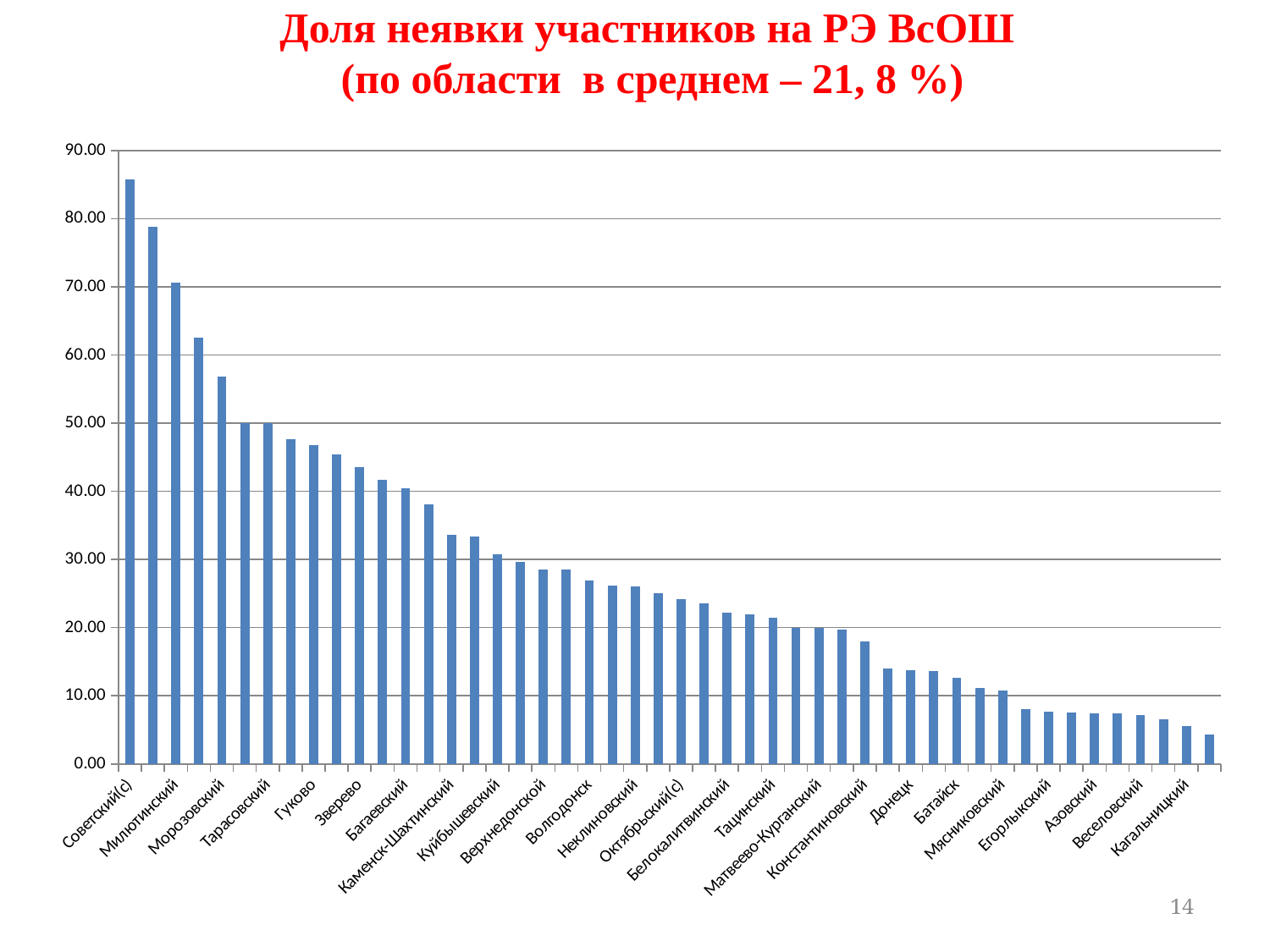
Is the value for Гуково greater or less than 50? less Is the value for Кагальницкий greater or less than 10? less Is the value for Милютинский greater or less than 60? greater Which category has the highest value? Советский(с) What kind of chart is shown on the slide? bar chart What average value for the region is stated in the chart title? 21, 8 % Do the values rise or fall from left to right along the x axis? fall Which is larger, the value for Советский(с) or the value for Азовский? Советский(с)